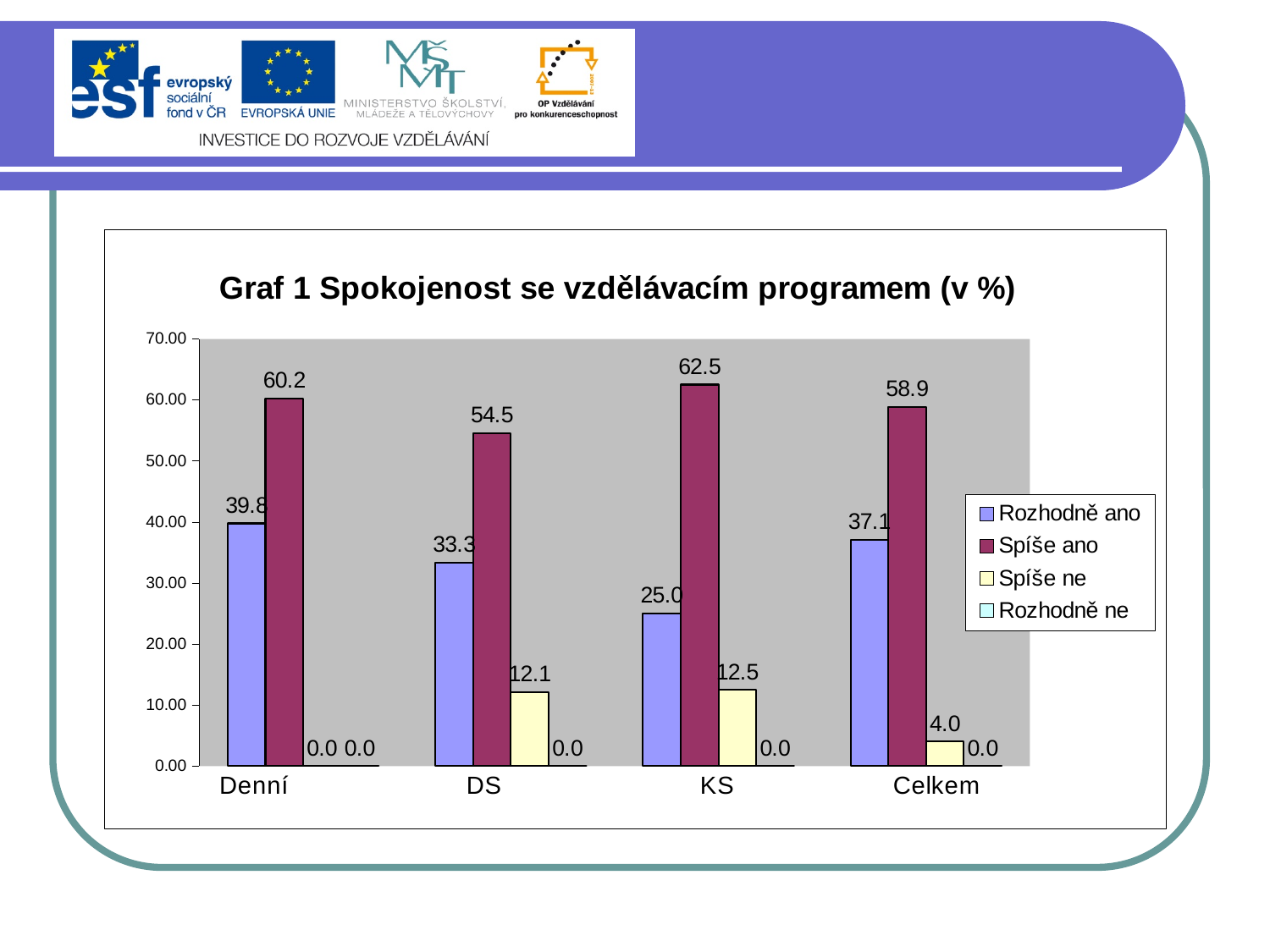
What kind of chart is shown on the slide? bar chart Which category has the lowest value for Rozhodně ano? KS What is the difference between Spíše ano and Rozhodně ano for Denní? 20.4 Which is larger for DS: Rozhodně ano or Spíše ano? Spíše ano What is the value of Rozhodně ano for Denní? 39.8 How many series does the legend list? 4 What is the value of Spíše ano for KS? 62.5 Is the value of Spíše ano for Celkem greater or less than 50.00? greater What is the title of the chart? Graf 1 Spokojenost se vzdělávacím programem (v %) How many categories are shown on the x axis? 4 What is the value of Spíše ne for Celkem? 4.0 Which category has the highest value for Spíše ano? KS